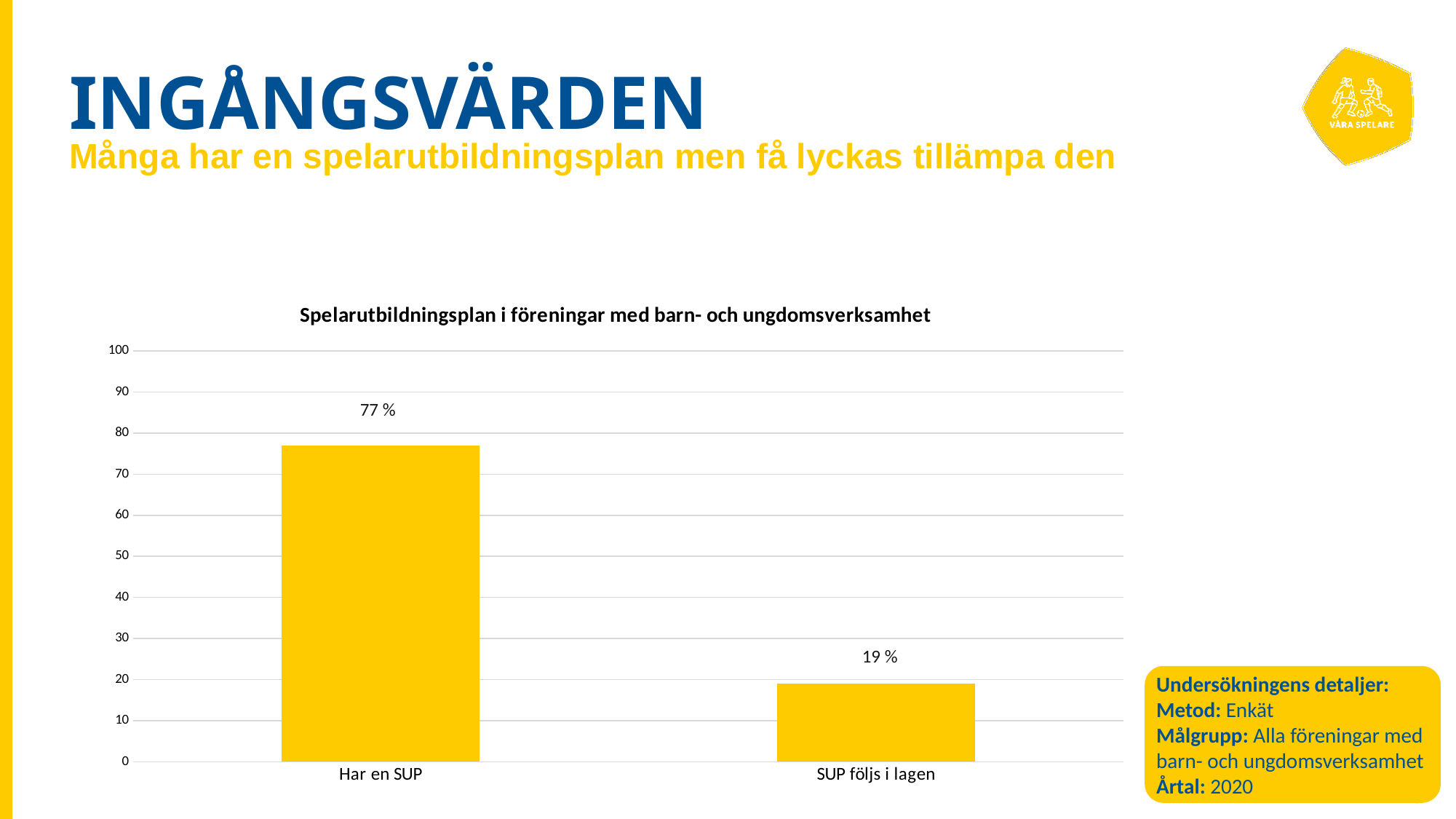
What is the value for "Har en SUP"? 77 % Which is larger, the value for "Har en SUP" or for "SUP följs i lagen"? Har en SUP What is the value for "SUP följs i lagen"? 19 % What is the maximum value shown on the vertical axis? 100 Is the value for "Har en SUP" greater or less than 70? greater What is the title of the chart? Spelarutbildningsplan i föreningar med barn- och ungdomsverksamhet Which category has the highest value? Har en SUP Is the value for "SUP följs i lagen" greater or less than 20? less How many categories are shown in the chart? 2 Which category has the lowest value? SUP följs i lagen What kind of chart is shown on the slide? bar chart What is the difference between the values for "Har en SUP" and "SUP följs i lagen"? 58 %